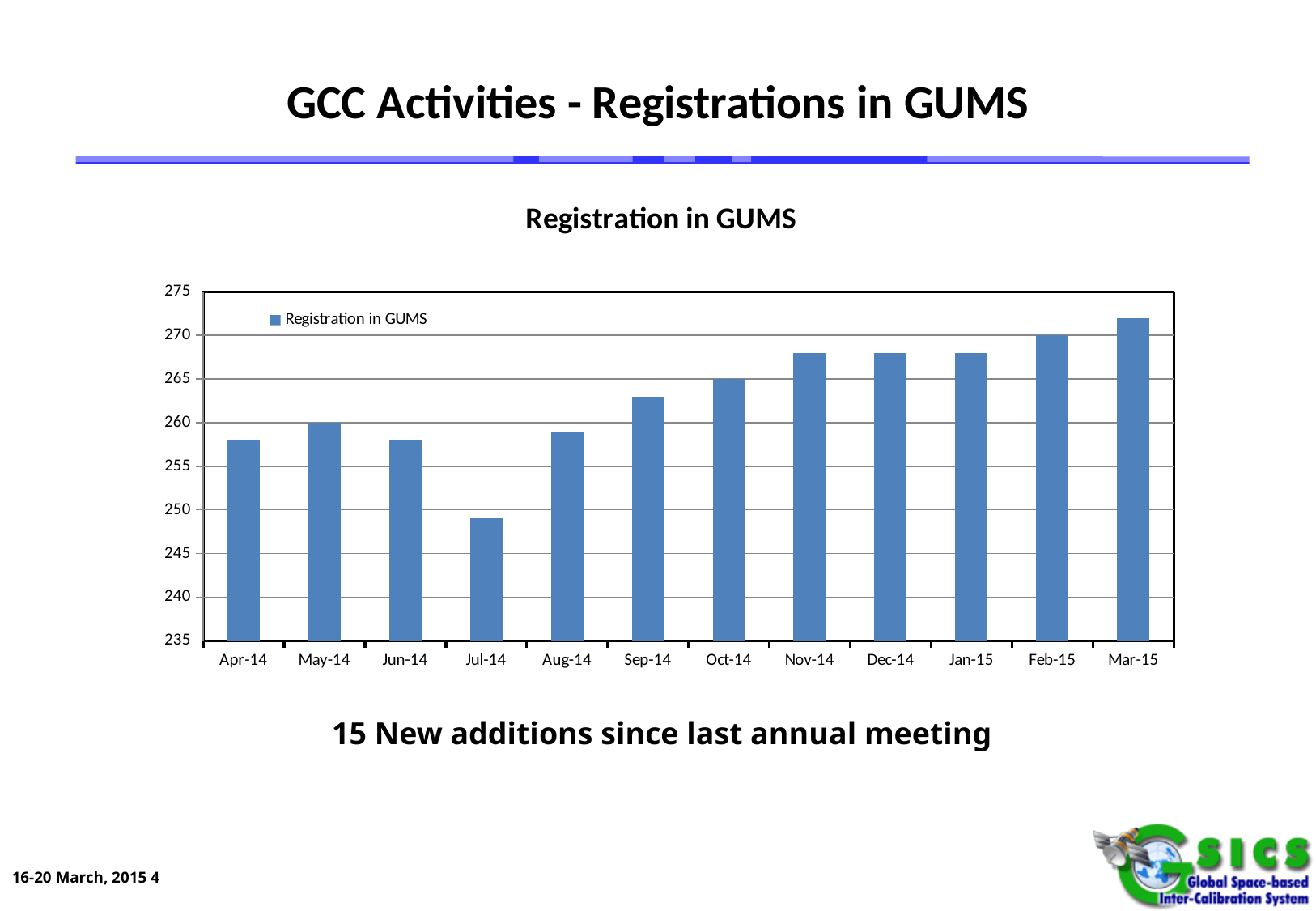
Is the value for Jul-14 greater or less than 250? less What type of chart is shown on the slide? bar chart Is the value for Mar-15 greater or less than 270? greater How many series does the legend list? 1 Which month has the highest number of registrations in GUMS? Mar-15 Which month has the lowest number of registrations in GUMS? Jul-14 How many months are shown on the x axis? 12 Which is larger, the value for Sep-14 or the value for Jun-14? Sep-14 What is the title of the chart? Registration in GUMS What is the value for Feb-15? 270 Do the registrations in GUMS generally rise or fall from Apr-14 to Mar-15? rise What is the value for May-14? 260